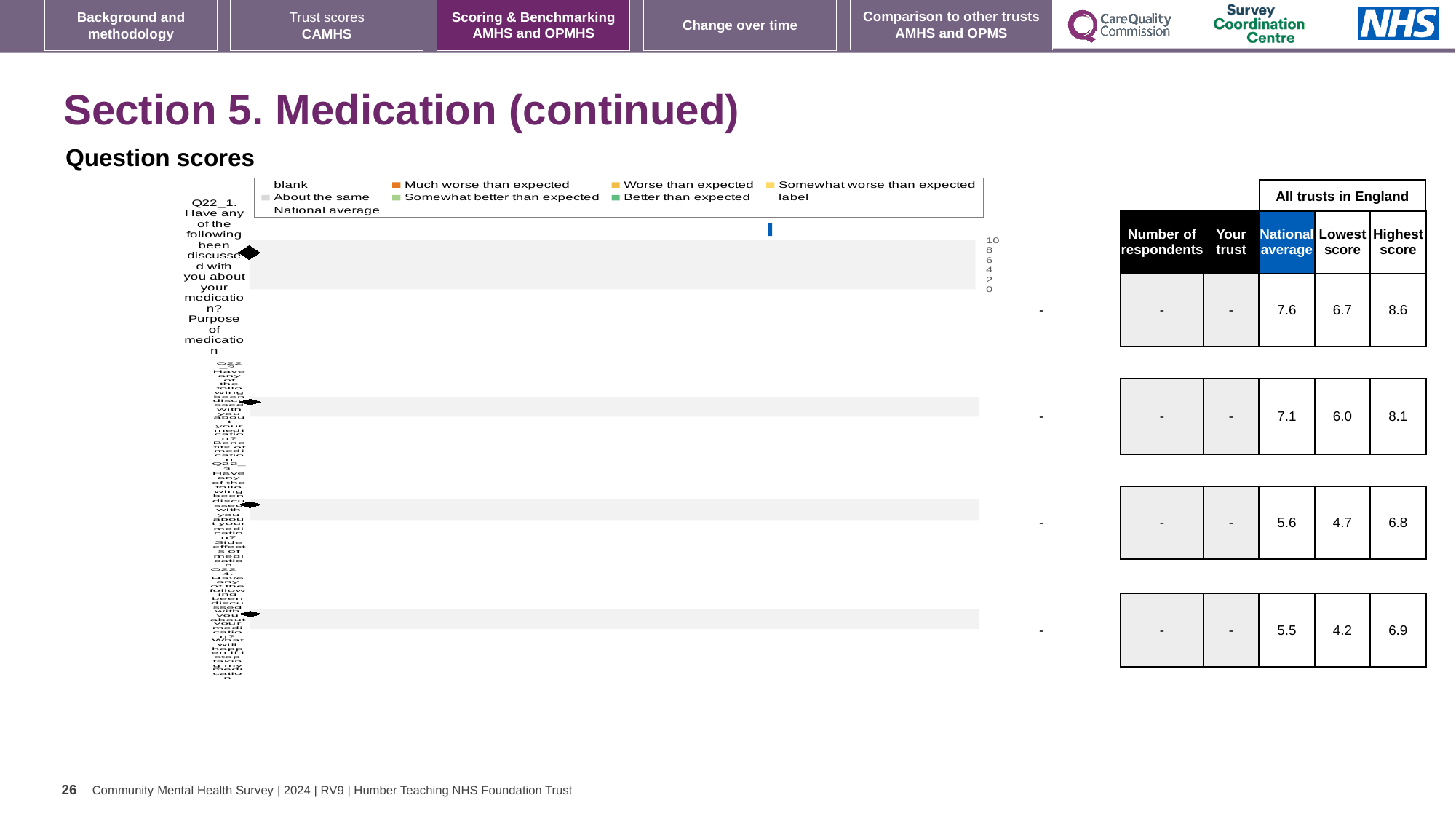
In the table beside the chart, what is the difference between the highest score and the lowest score for Q22_1? 1.9 In the table beside the chart, which row has the lowest national average? the fourth row, 5.5 In the table beside the chart, what is the highest score for Q22_1 (Purpose of medication)? 8.6 How many question categories (rows) are plotted in the chart? 4 In the table beside the chart, which row has the highest national average? Q22_1 (Purpose of medication), 7.6 In the table beside the chart, what is the national average for Q22_1 (Purpose of medication)? 7.6 In the table beside the chart, what is the lowest score for Q22_1 (Purpose of medication)? 6.7 What value is shown for 'Your trust' in each row of the table? - Which legend entry is shown in orange? Much worse than expected In the table beside the chart, is the national average for the second row (7.1) larger or smaller than that for the third row (5.6)? larger What kind of chart is shown under 'Question scores'? bar chart What is the highest value shown on the chart's numeric axis? 10